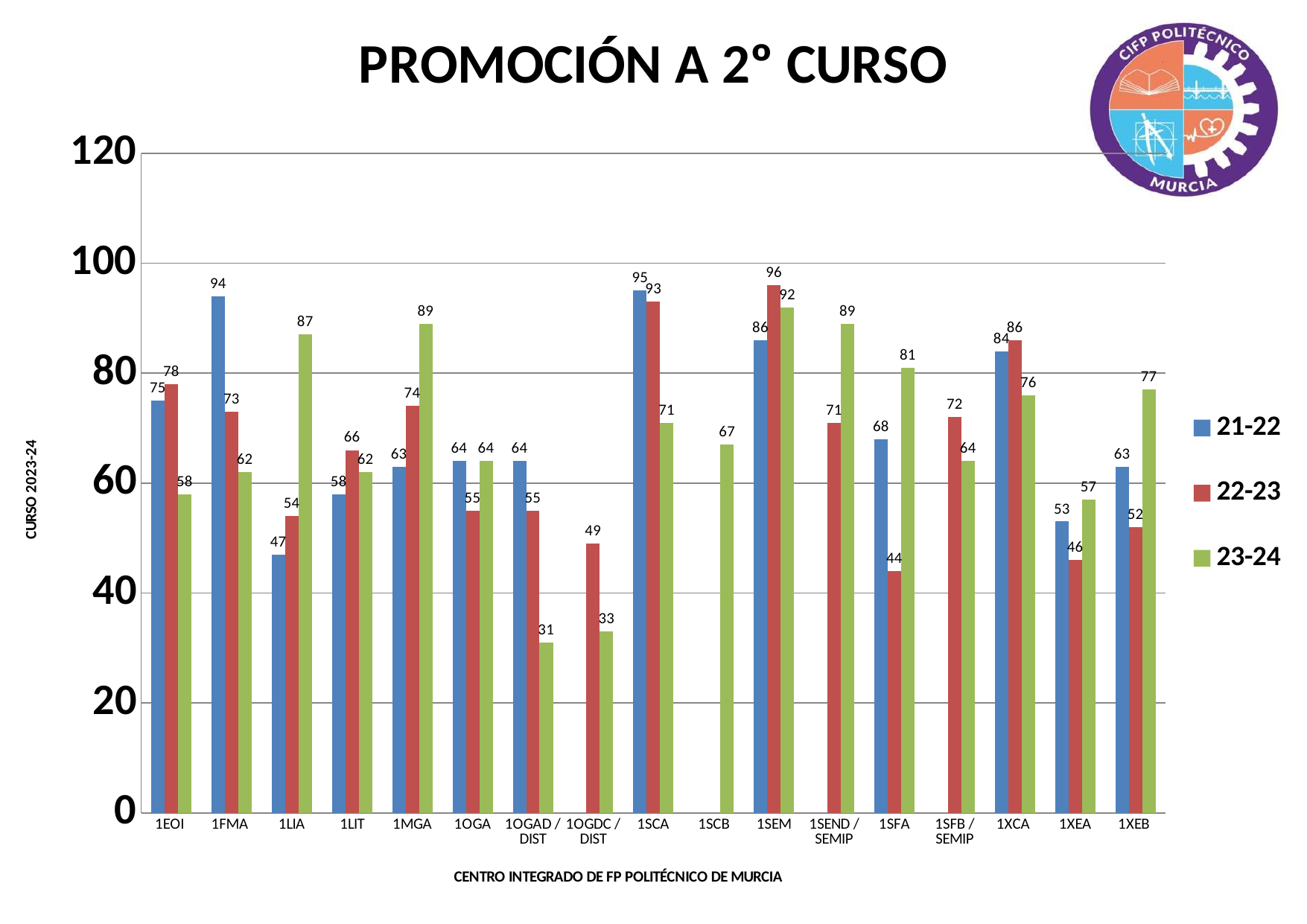
What is the difference between the 23-24 and 21-22 values for 1LIA? 40 What is the 22-23 value for 1SEM? 96 How many series does the legend list? 3 What kind of chart is shown on the slide? bar chart What is the 23-24 value for 1LIA? 87 Which category has the lowest 23-24 value? 1OGAD / DIST Which is larger for 1XEB: the 21-22 value or the 23-24 value? 23-24 What is the title of the chart? PROMOCIÓN A 2º CURSO Which category has the highest 21-22 value? 1SCA How many categories are shown on the x axis? 17 Which category has the lowest 22-23 value? 1SFA What is the 21-22 value for 1FMA? 94